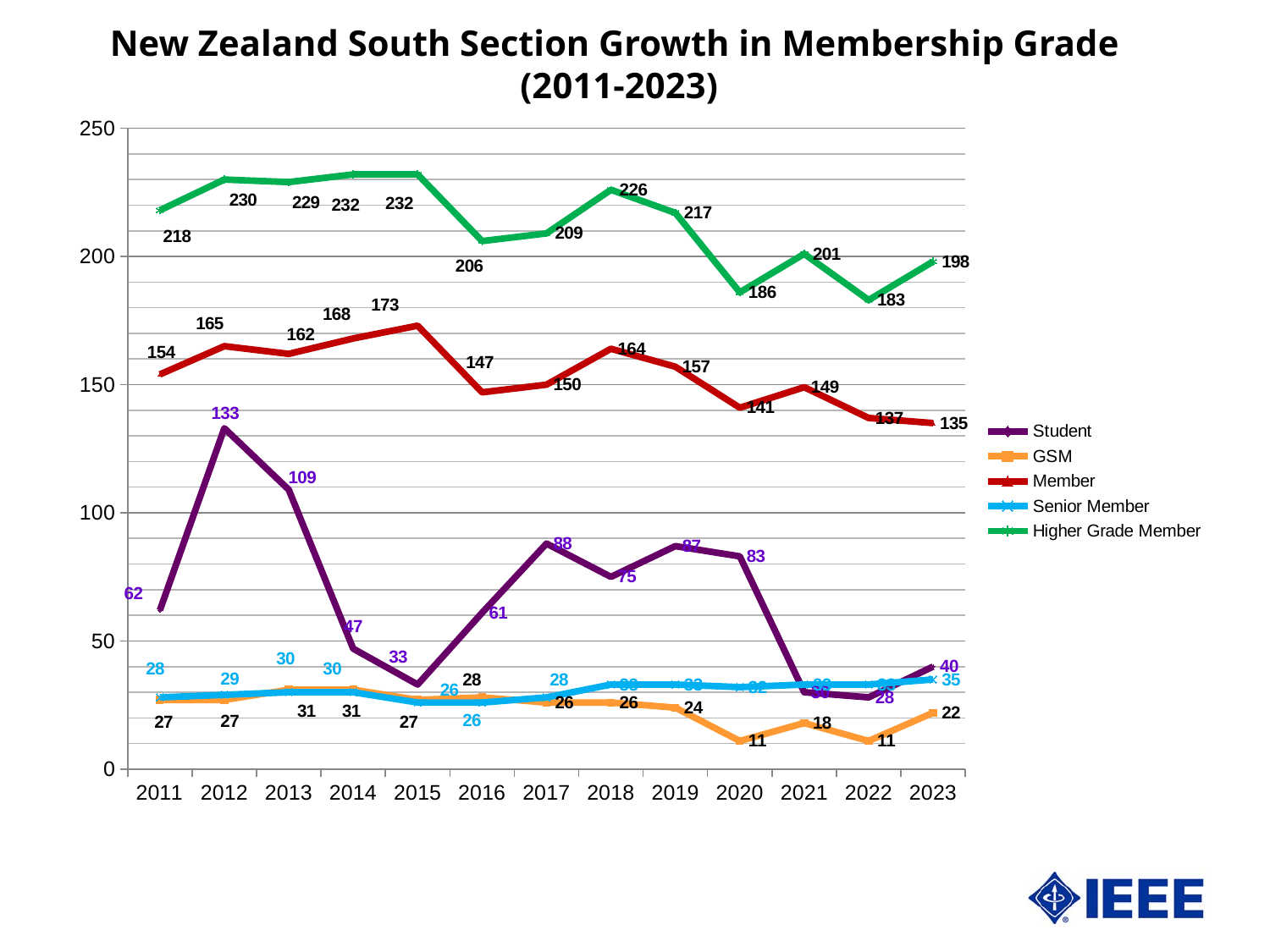
What is the difference between the Higher Grade Member values for 2011 and 2023? 20 What kind of chart is shown on the slide? line chart In which year is the Member series at its highest? 2015 What is the Member value for 2015? 173 What is the Higher Grade Member value for 2011? 218 In which year is the Higher Grade Member series at its lowest? 2022 What is the GSM value for 2023? 22 How many years are plotted along the x axis? 13 Does the Student series rise or fall from 2012 to 2015? fall How many series does the legend list? 5 Which is larger in 2012, the Student value or the Member value? Member What is the Student value for 2012? 133